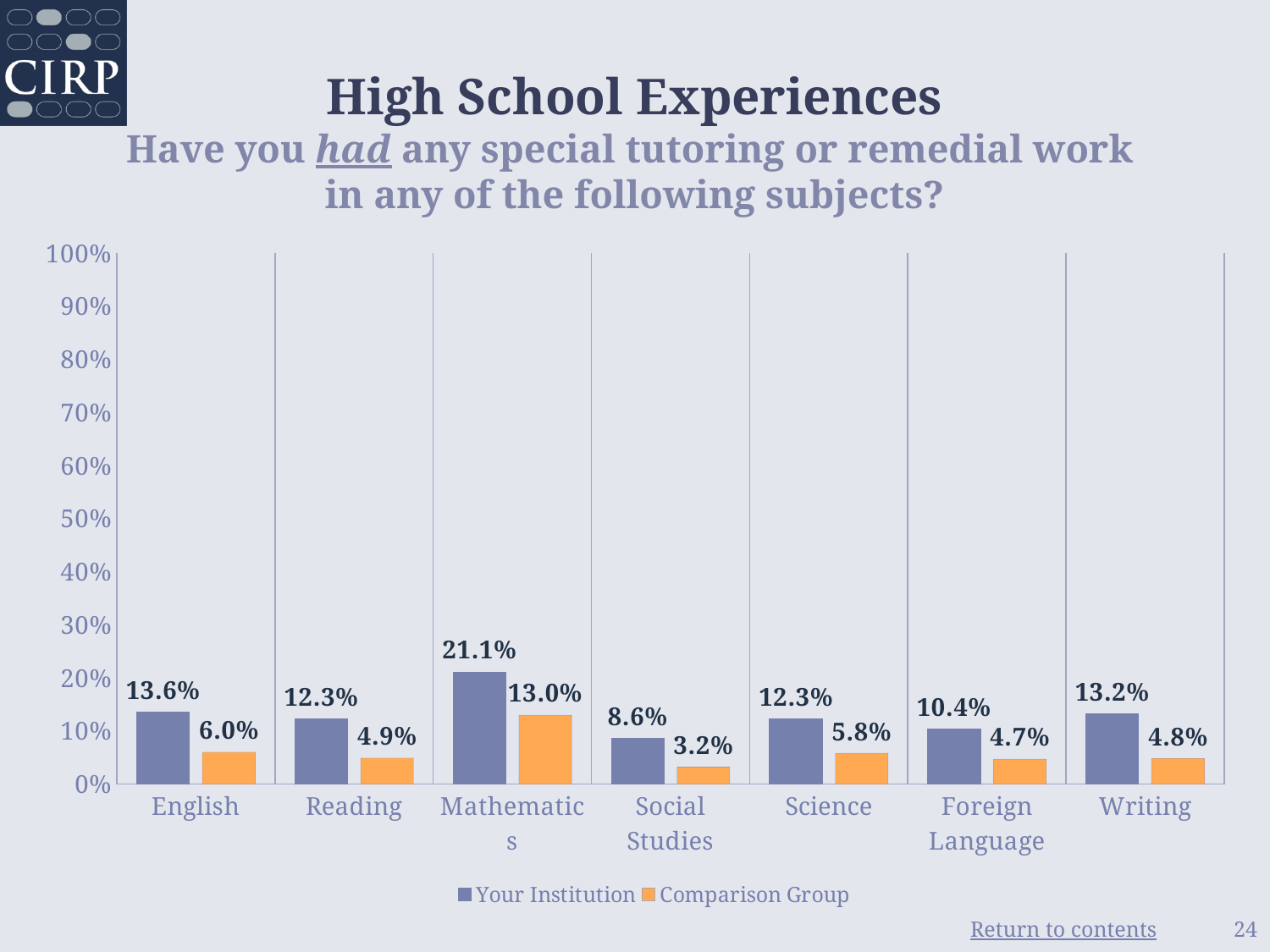
What are the two series named in the legend? Your Institution and Comparison Group Which subject has the lowest value for Comparison Group? Social Studies What is the difference between Your Institution and Comparison Group for English? 7.6% What is the value for Your Institution for Foreign Language? 10.4% What is the value for Comparison Group for Social Studies? 3.2% Which subject has the highest value for Your Institution? Mathematics What kind of chart is shown on the slide? bar chart Is the value for Your Institution for Mathematics greater or less than 20%? greater What is the value for Your Institution for Mathematics? 21.1% How many subjects are shown on the x axis? 7 How many series does the legend list? 2 Which is larger for Science: Your Institution or Comparison Group? Your Institution